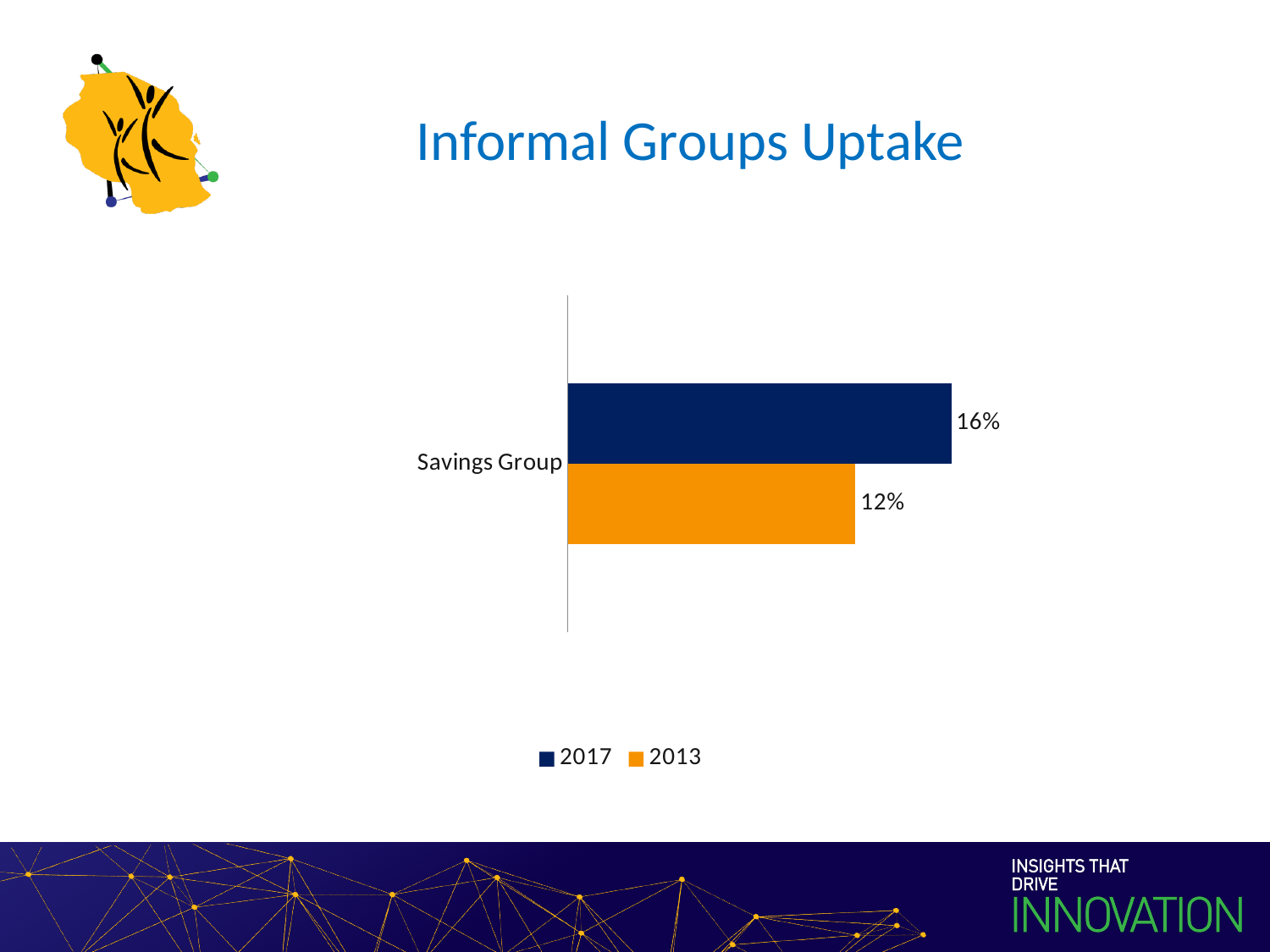
How many categories are shown on the chart? 1 What is the title of the slide? Informal Groups Uptake Which series is shown in orange? 2013 Did the Savings Group value rise or fall from 2013 to 2017? Rise What is the difference between the 2017 and 2013 values for Savings Group? 4% What is the value for Savings Group in 2017? 16% How many series does the legend list? 2 Which year has the higher value for Savings Group, 2017 or 2013? 2017 What kind of chart is shown on the slide? Bar chart What is the value for Savings Group in 2013? 12%